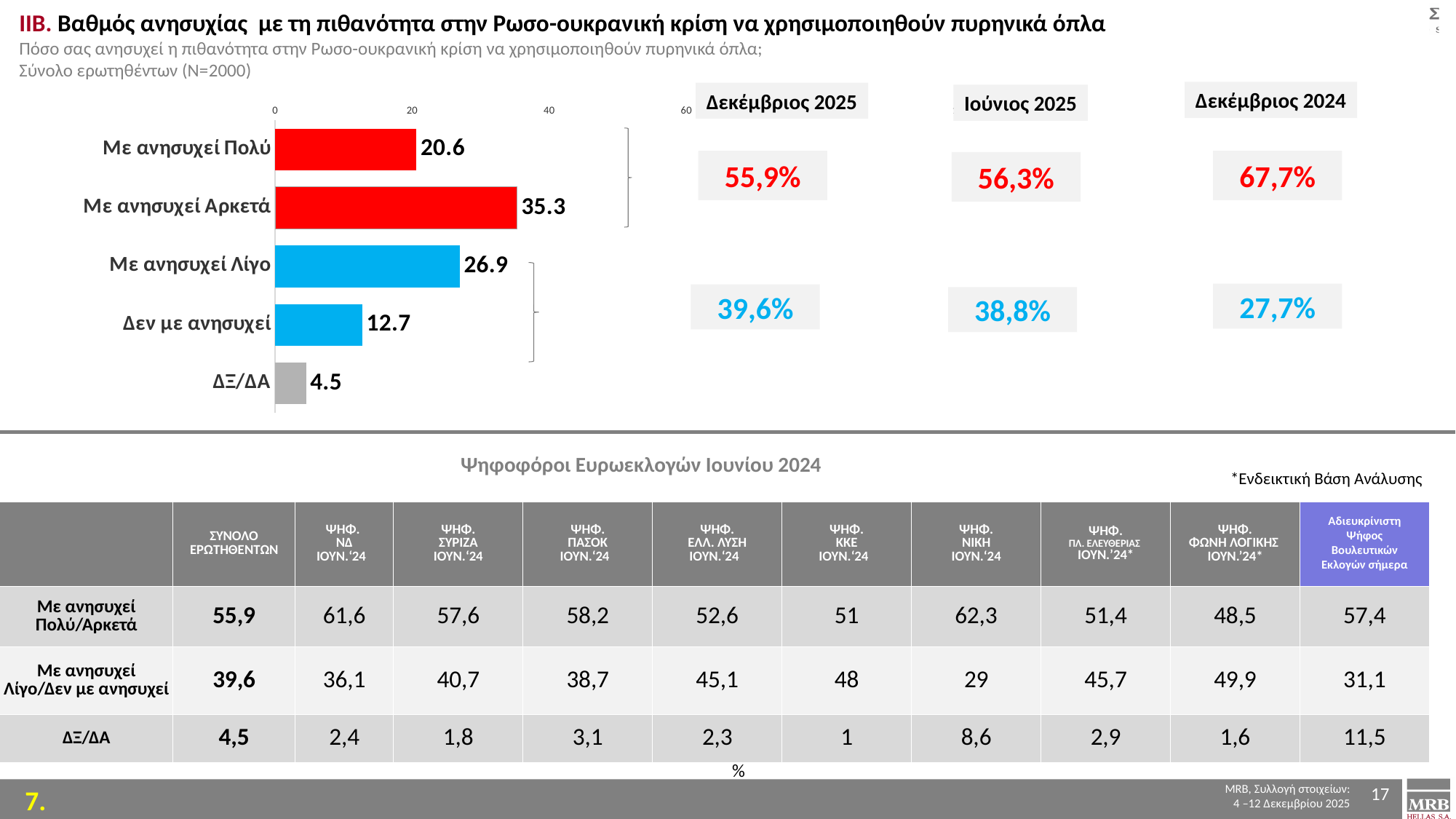
What is the value for "ΔΞ/ΔΑ" in the bar chart? 4.5 How many categories are shown in the bar chart? 5 Which category has the lowest value in the bar chart? ΔΞ/ΔΑ What is the value for "Με ανησυχεί Αρκετά" in the bar chart? 35.3 What type of chart is shown on the slide? bar chart Is the value for "Με ανησυχεί Λίγο" greater or less than 20? greater What is the difference between the values for "Με ανησυχεί Αρκετά" and "Με ανησυχεί Πολύ" in the bar chart? 14.7 Which is larger in the bar chart: "Με ανησυχεί Λίγο" or "Με ανησυχεί Πολύ"? Με ανησυχεί Λίγο What colour are the bars for "Με ανησυχεί Πολύ" and "Με ανησυχεί Αρκετά" in the bar chart? red What is the value for "Με ανησυχεί Πολύ" in the bar chart? 20.6 What is the value for "Δεν με ανησυχεί" in the bar chart? 12.7 Which category has the highest value in the bar chart? Με ανησυχεί Αρκετά